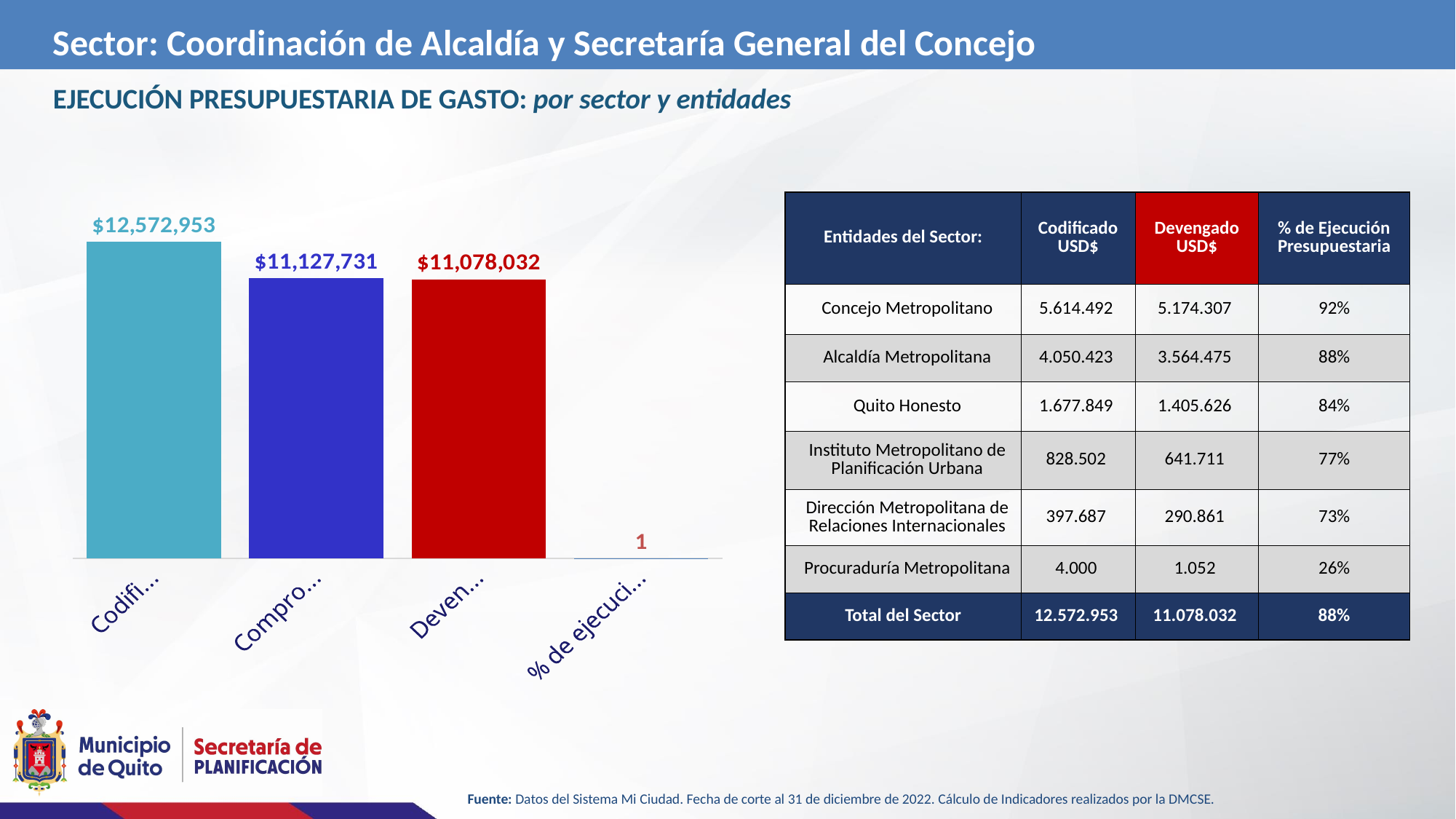
Which is larger, the 'Codifi...' bar or the 'Compro...' bar? Codifi... What value is labelled for the last category, '% de ejecuci...'? 1 What value is labelled on the first (light blue) bar, 'Codifi...'? $12,572,953 Which category in the chart has the lowest value? % de ejecuci... What colour is the 'Deven...' bar in the chart? red What is the difference between the 'Codifi...' bar and the 'Deven...' bar? $1,494,921 Which bar in the chart has the highest value? Codifi... What type of chart is shown on the left of the slide? bar chart What is the difference between the 'Compro...' bar and the 'Deven...' bar? $49,699 How many bars/categories does the chart on the left show? 4 What value is labelled on the third (red) bar, 'Deven...'? $11,078,032 What value is labelled on the second (blue) bar, 'Compro...'? $11,127,731